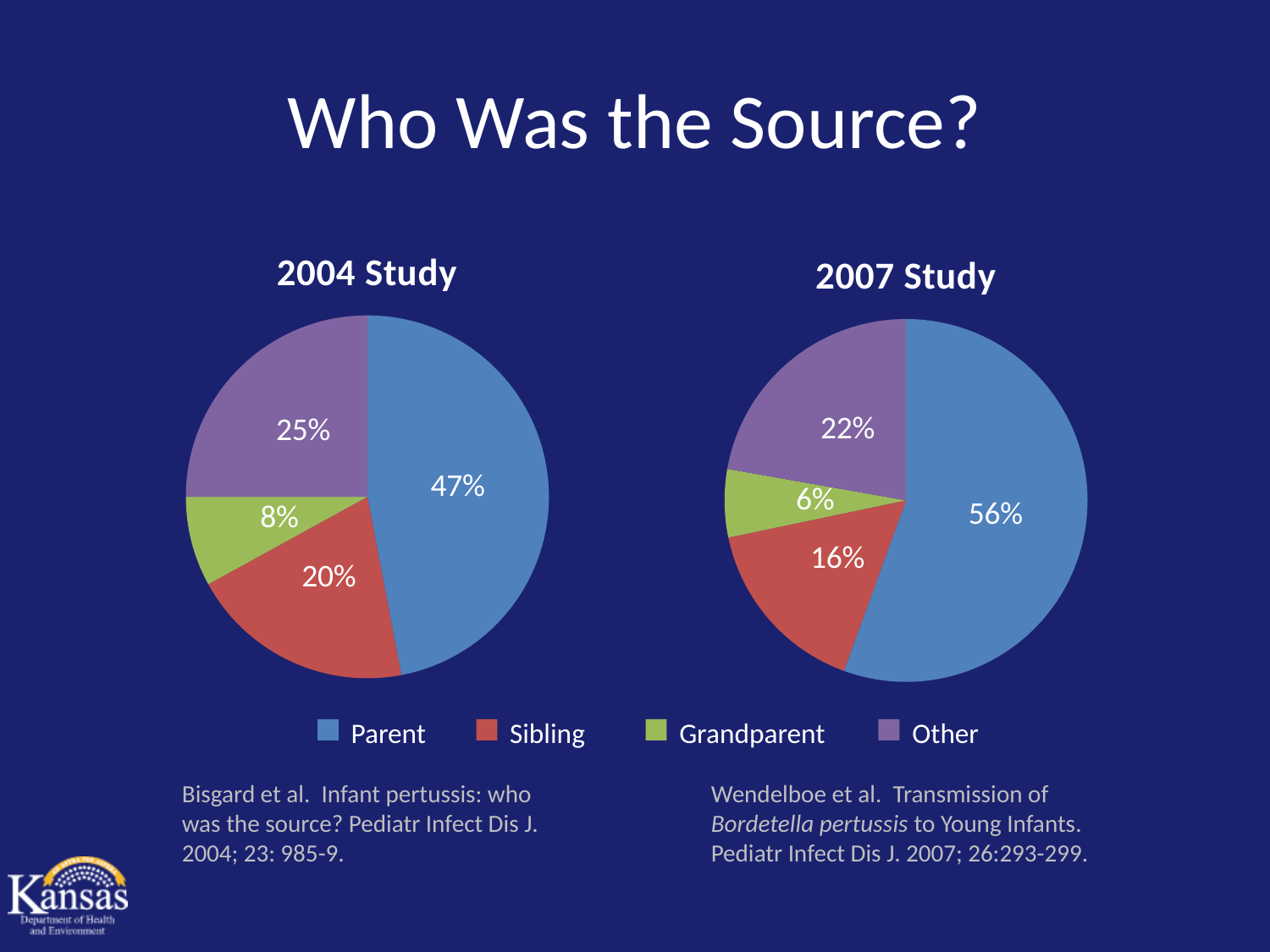
In the 2007 Study pie chart, what share of the pie is Other? 22% What type of chart is used for the 2004 Study? Pie chart In the 2004 Study pie chart, which is larger, the Sibling slice or the Other slice? Other In the 2004 Study pie chart, which category has the smallest slice? Grandparent Which colour represents Sibling in the legend? Red How many categories does the legend list for the pie charts? 4 In the 2007 Study pie chart, which category has the largest slice? Parent What is the difference between the Parent share in the 2007 Study and the Parent share in the 2004 Study? 9 percentage points In the 2007 Study pie chart, which category has the smallest slice? Grandparent In the 2004 Study pie chart, what share of the pie is Parent? 47% In the 2007 Study pie chart, what share of the pie is Sibling? 16% In the 2004 Study pie chart, what share of the pie is Grandparent? 8%